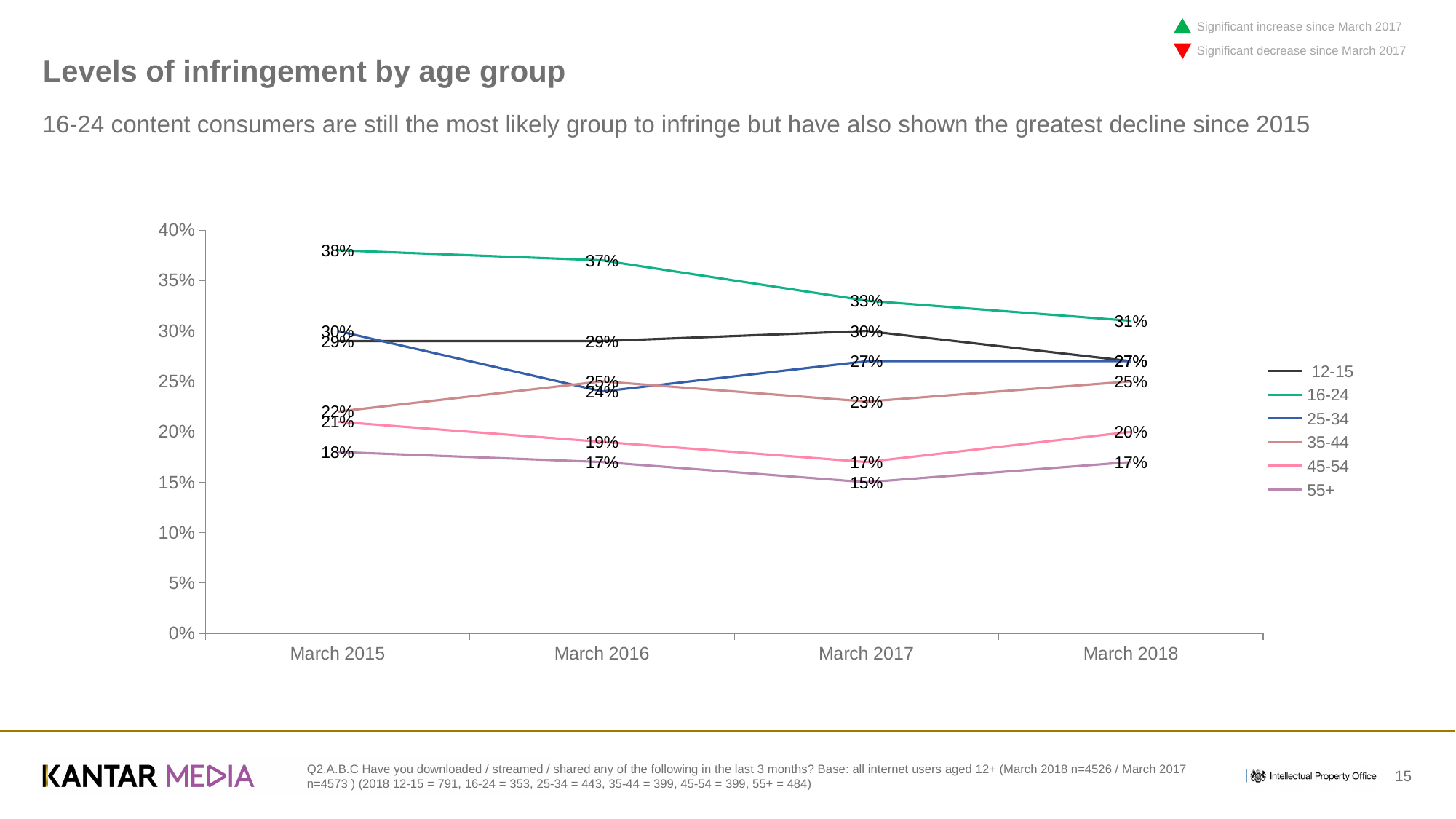
Does the 16-24 line rise or fall from March 2015 to March 2018? fall Which age group has the lowest value in March 2017? 55+ Which age group has the highest value in March 2018? 16-24 Which is larger in March 2016: the value for 25-34 or the value for 35-44? 35-44 How many time points are shown on the x axis? 4 What is the title of the chart slide? Levels of infringement by age group What is the value for the 16-24 group in March 2015? 38% What is the value for the 55+ group in March 2017? 15% How many series does the legend list? 6 What is the value for the 35-44 group in March 2016? 25% What type of chart is shown on the slide? line chart What is the difference between the 16-24 value in March 2015 and in March 2018? 7 percentage points